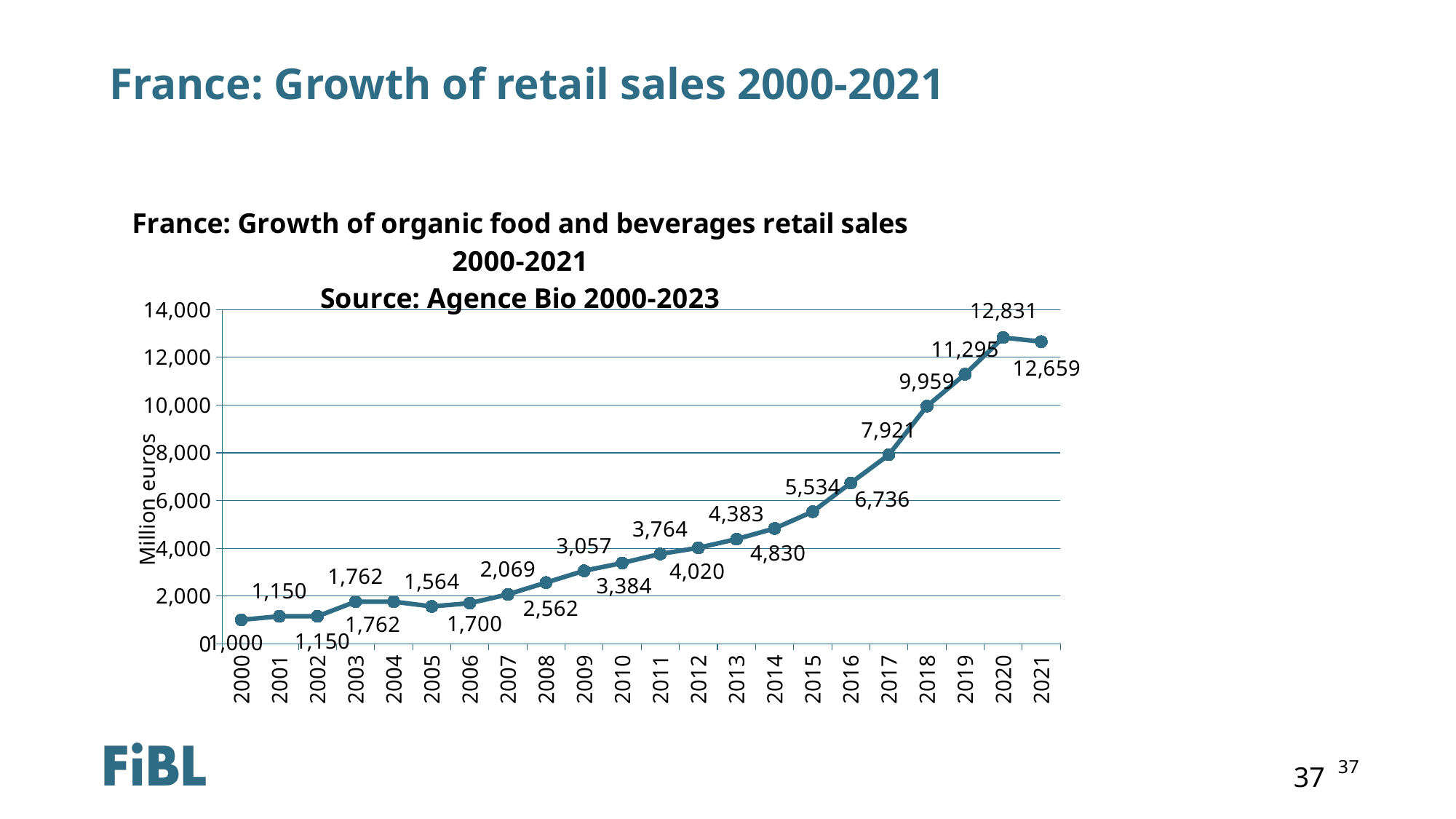
Is the value for 2019 greater or less than 10,000? greater What is the difference between the values for 2018 and 2017? 2,038 What is the value for 2010? 3,384 Which is larger, the value for 2016 or the value for 2015? 2016 What is the value for 2005? 1,564 What is the value for 2021? 12,659 Which year has the highest value? 2020 What is the label of the y axis? Million euros Which year has the lowest value? 2000 What is the difference between the values for 2020 and 2021? 172 How many years are plotted on the x axis? 22 What kind of chart is shown? line chart